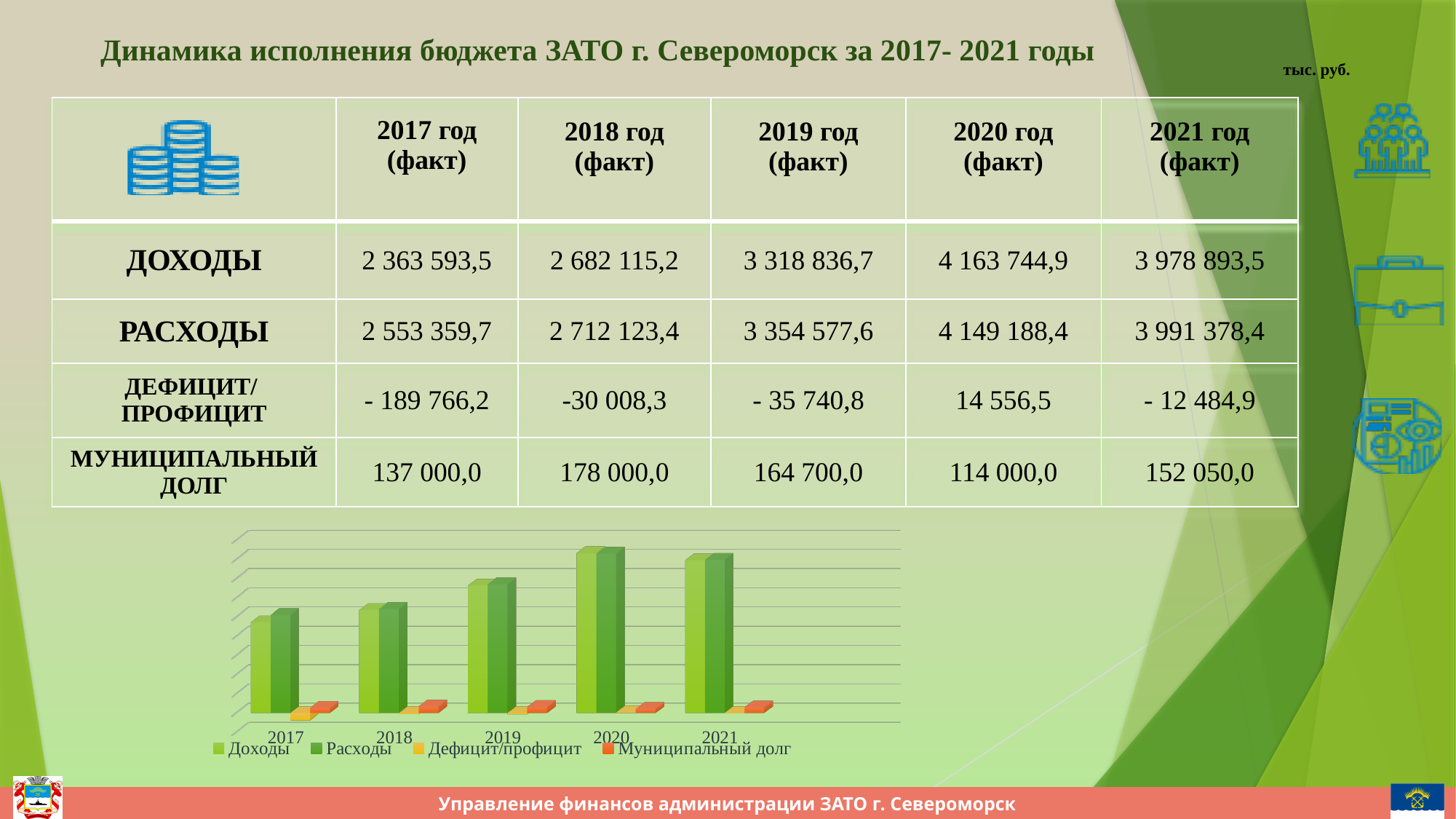
According to the slide, what is the value of Доходы for 2020 (факт)? 4 163 744,9 Do the Доходы bars rise or fall from 2017 to 2020? rise What kind of chart is shown on the slide? bar chart What is the title of the slide containing the chart? Динамика исполнения бюджета ЗАТО г. Североморск за 2017- 2021 годы Which is larger in 2021, the Доходы bar or the Муниципальный долг bar? Доходы According to the slide, what is the value of Муниципальный долг for 2018 (факт)? 178 000,0 In which year is the Доходы bar the highest? 2020 How many years (categories) are shown on the x axis of the chart? 5 How many series does the chart legend list? 4 Which series are listed in the chart legend? Доходы, Расходы, Дефицит/профицит, Муниципальный долг Which is larger, the Расходы bar for 2017 or the Расходы bar for 2019? 2019 In which year is the Доходы bar the lowest? 2017